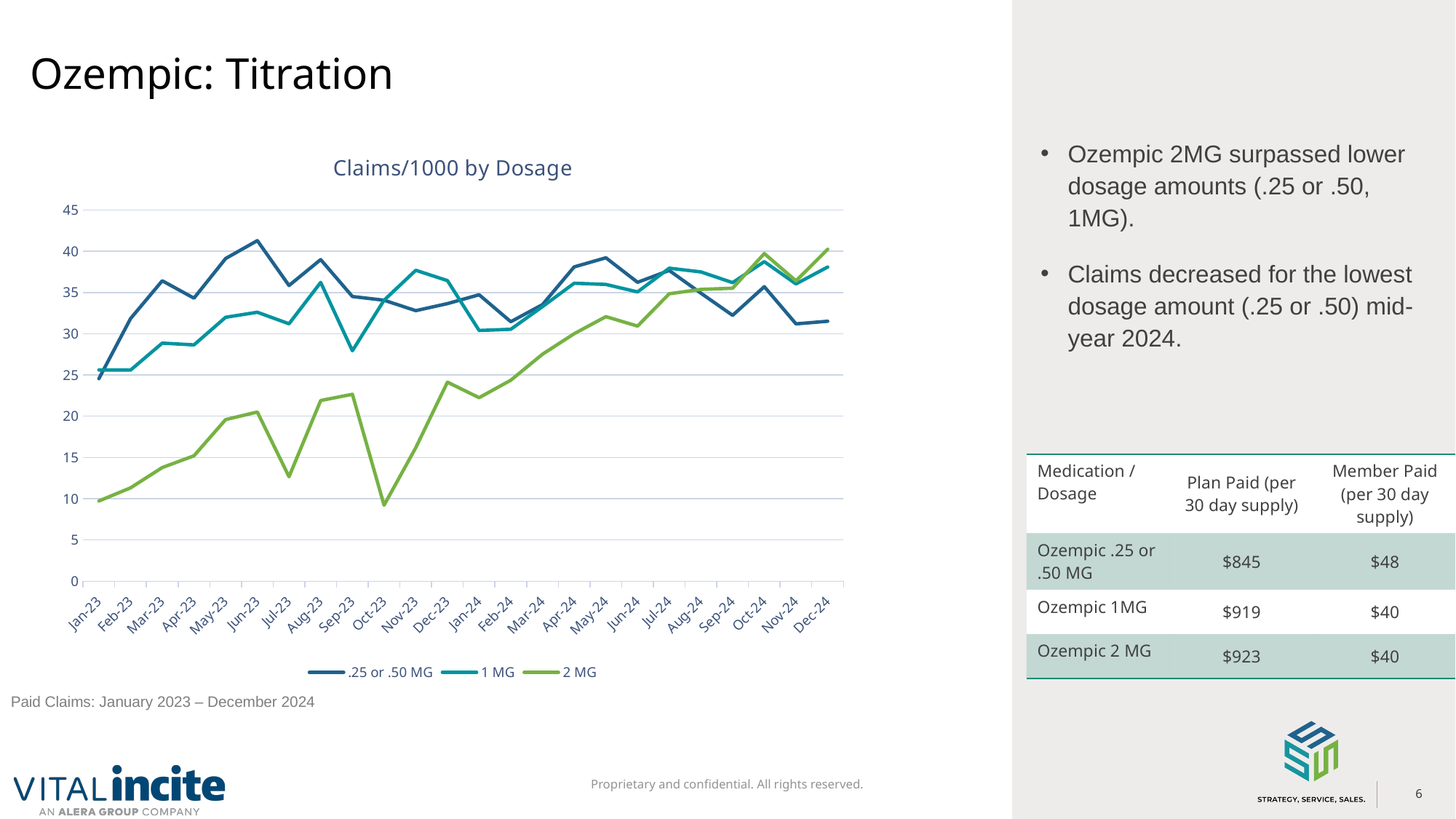
Which series is drawn in green in the chart? 2 MG Is the value for 1 MG in Sep-23 greater or less than 30? less Does the 2 MG series generally rise or fall from Jan-23 to Dec-24? rise Is the value for .25 or .50 MG in Jun-23 greater or less than 40? greater Which series has the lowest value in Jan-23? 2 MG Is the value for 2 MG in Oct-23 greater or less than 15? less Which series has the highest value in Jun-23? .25 or .50 MG How many series does the legend of the chart list? 3 What is the title of the chart? Claims/1000 by Dosage What kind of chart is shown on the slide? line chart How many months are plotted along the x axis of the chart? 24